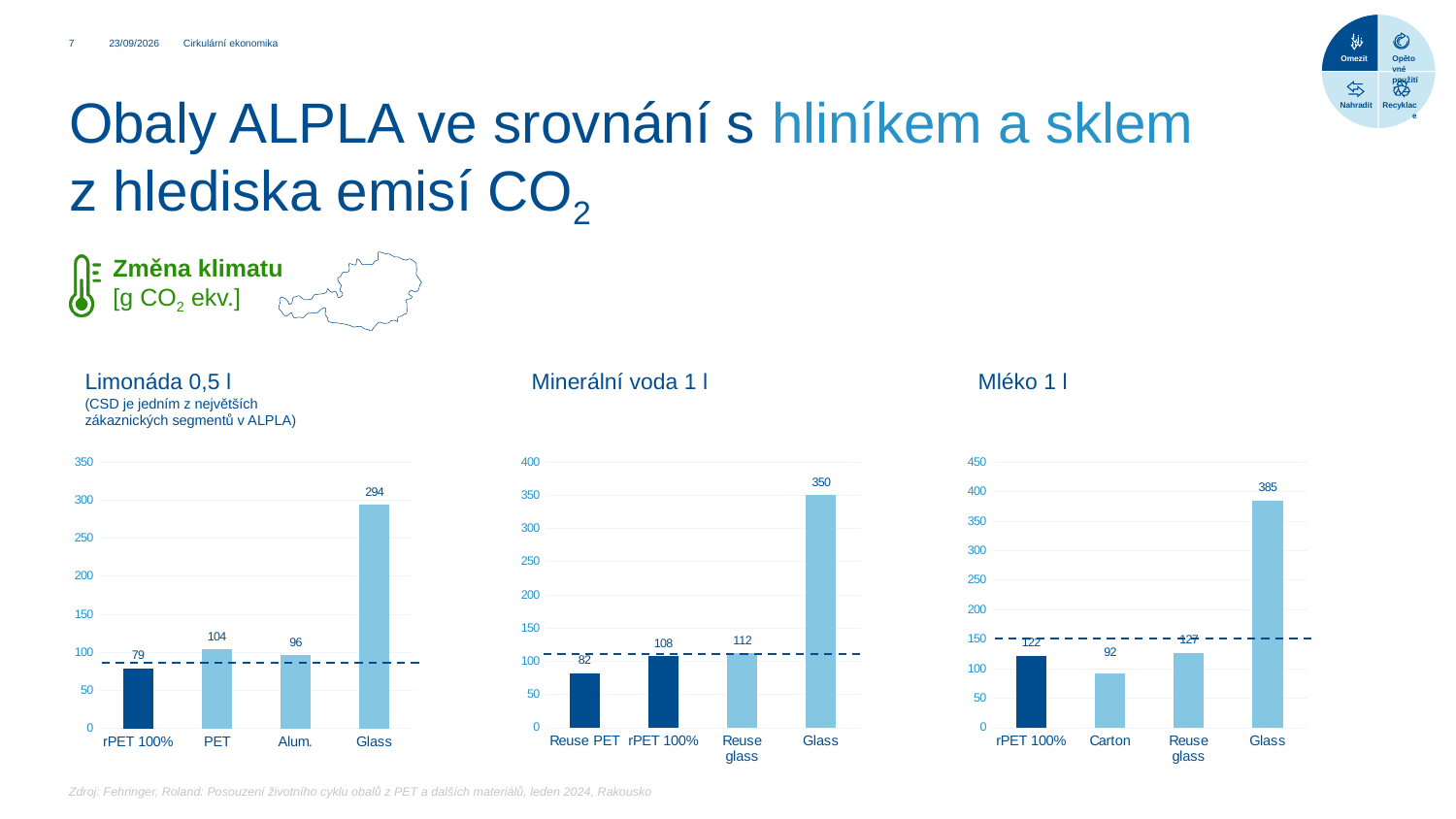
In the Minerální voda 1 l chart, which category has the highest value? Glass In the Limonáda 0,5 l chart, which category has the lowest value? rPET 100% In the Limonáda 0,5 l chart, what is the difference between PET and Alum.? 8 In the Limonáda 0,5 l chart, what is the value for Glass? 294 In the Minerální voda 1 l chart, how many categories are shown? 4 In the Mléko 1 l chart, which is larger, rPET 100% or Reuse glass? Reuse glass What type of chart is the Mléko 1 l chart? Bar chart In the Minerální voda 1 l chart, what is the difference between Glass and Reuse PET? 268 In the Minerální voda 1 l chart, what is the value for Reuse glass? 112 In the Mléko 1 l chart, what is the difference between Glass and Carton? 293 In the Mléko 1 l chart, what is the value for Carton? 92 In the Limonáda 0,5 l chart, what is the value for rPET 100%? 79